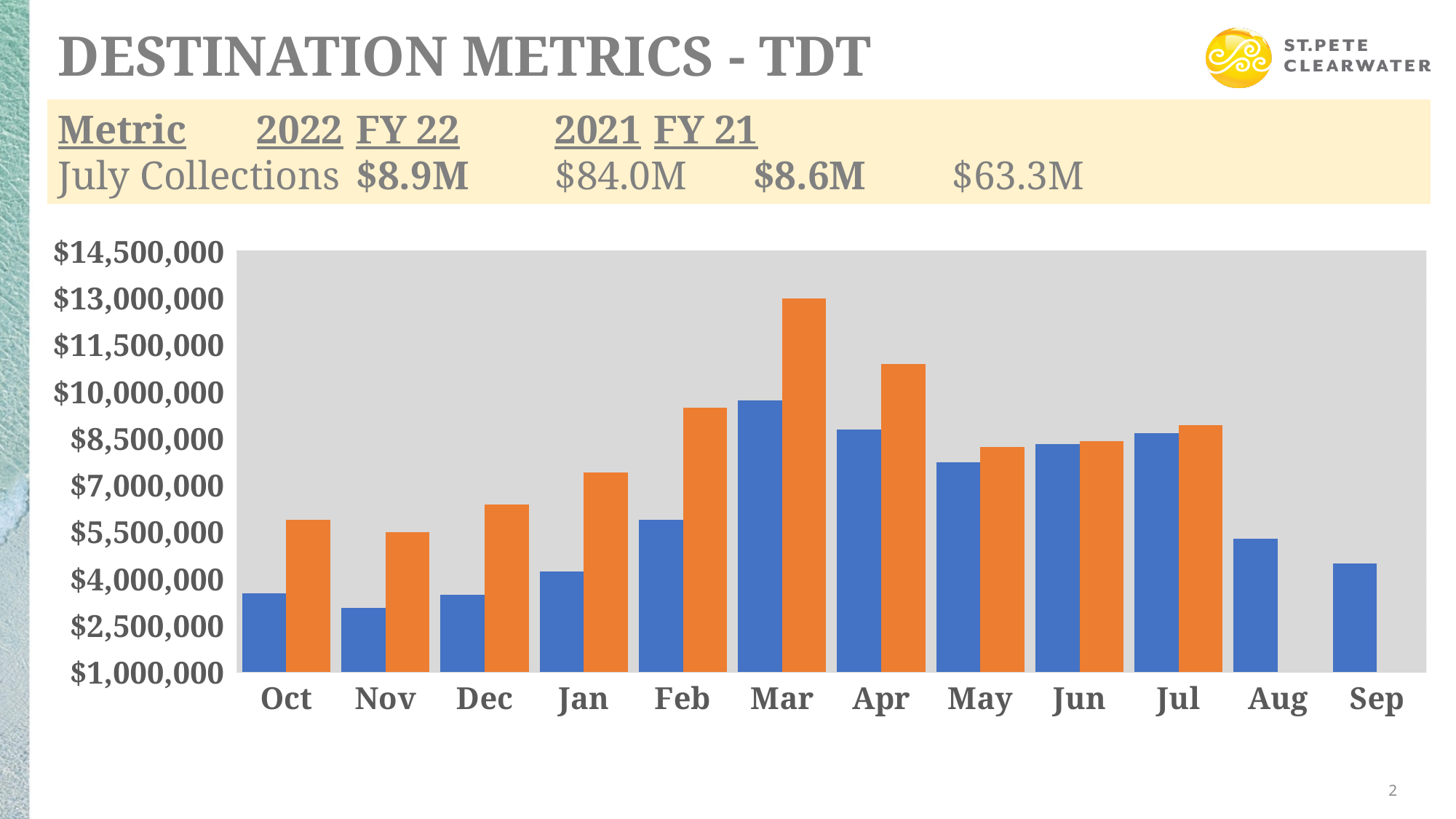
In Oct, which bar is taller, the blue bar or the orange bar? orange Is the orange bar for Apr greater or less than $10,000,000? greater Do the orange bars rise or fall from Mar to May? fall How many months are shown along the x axis of the chart? 12 Which months have only a blue bar and no orange bar? Aug and Sep Is the blue bar for Jan greater or less than $5,500,000? less Is the orange bar for Mar greater or less than $11,500,000? greater Which month has the tallest orange bar? Mar Which month has the shortest blue bar? Nov Which month has the tallest blue bar? Mar What kind of chart is shown on the slide? bar chart